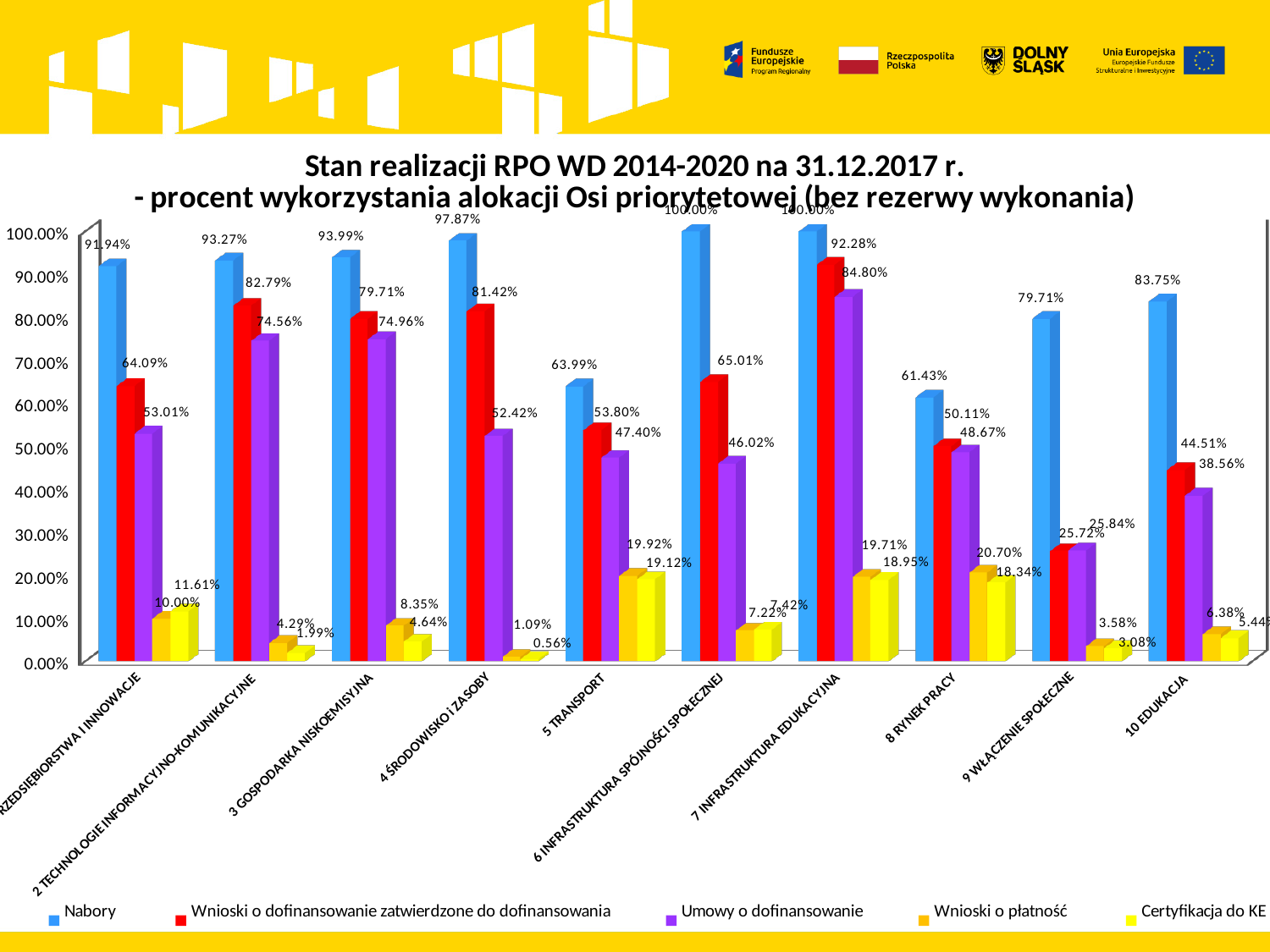
What is the value of Certyfikacja do KE for 1 PRZEDSIĘBIORSTWA I INNOWACJE? 11.61% How many series does the legend list? 5 What kind of chart is shown on the slide? bar chart What is the value of Umowy o dofinansowanie for 7 INFRASTRUKTURA EDUKACYJNA? 84.80% Which has a higher value for Wnioski o dofinansowanie zatwierdzone do dofinansowania: 2 TECHNOLOGIE INFORMACYJNO-KOMUNIKACYJNE or 3 GOSPODARKA NISKOEMISYJNA? 2 TECHNOLOGIE INFORMACYJNO-KOMUNIKACYJNE How many categories are shown on the x axis? 10 Which category has the lowest value for Nabory? 8 RYNEK PRACY Which category has the highest value for Wnioski o płatność? 8 RYNEK PRACY What is the difference between Nabory and Umowy o dofinansowanie for 3 GOSPODARKA NISKOEMISYJNA? 19.03% Which category has the lowest value for Certyfikacja do KE? 4 ŚRODOWISKO I ZASOBY Is the value of Nabory for 10 EDUKACJA greater or less than 80.00%? greater What is the value of Nabory for 5 TRANSPORT? 63.99%